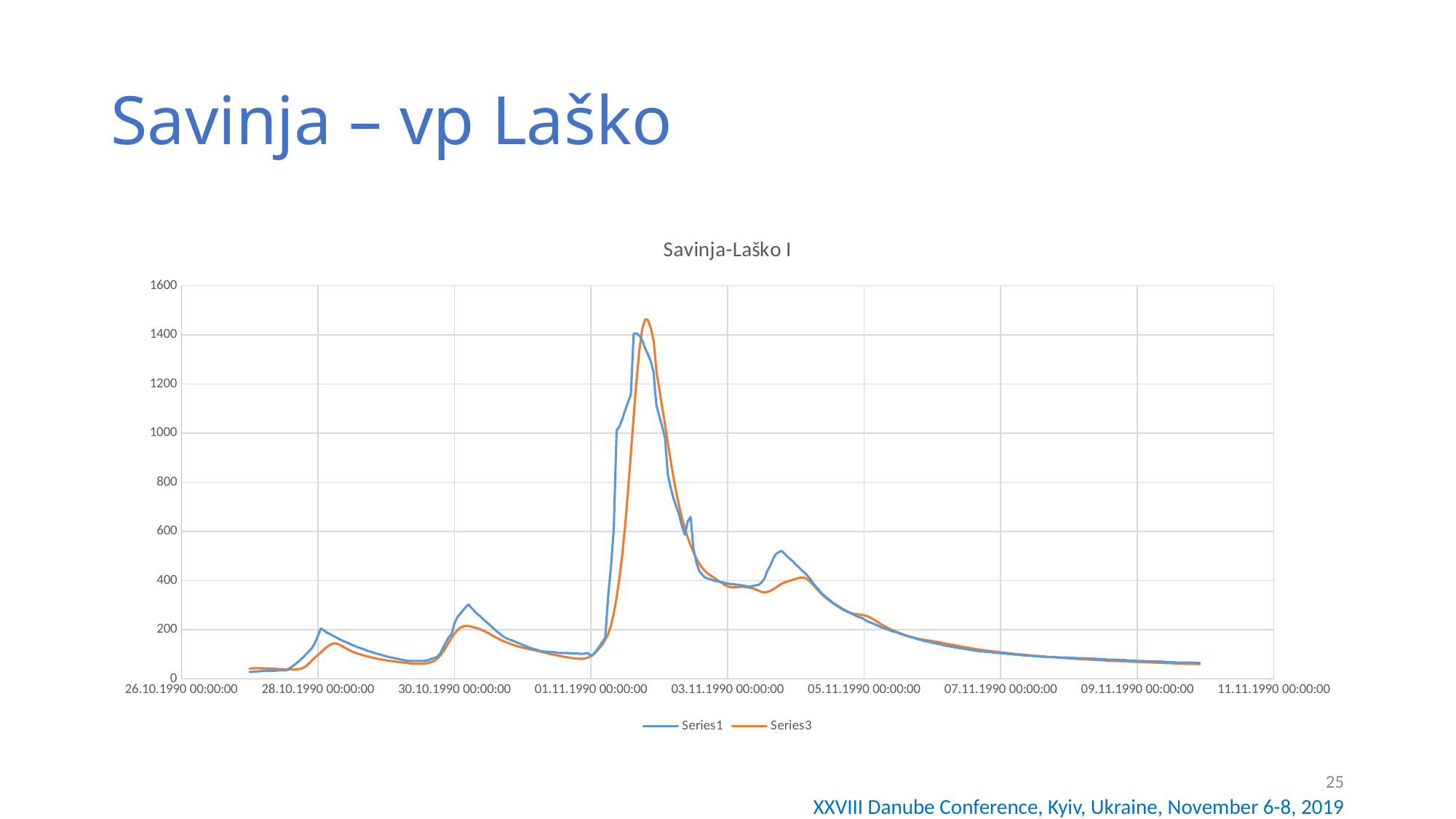
Is the value of Series3 at 07.11.1990 00:00:00 greater or less than 400? less Which series reaches the highest peak value, Series1 or Series3? Series3 Is the peak value of Series3 greater or less than 1400? greater What is the highest value shown on the y axis? 1600 Is the peak value of Series1 greater or less than 1200? greater Do the values rise or fall along the x axis after the main peak near 02.11.1990? fall What kind of chart is shown on the slide? line chart What are the names of the two series in the legend? Series1 and Series3 What is the title of the chart? Savinja-Laško I How many series does the legend list? 2 How many date labels are shown on the x axis? 9